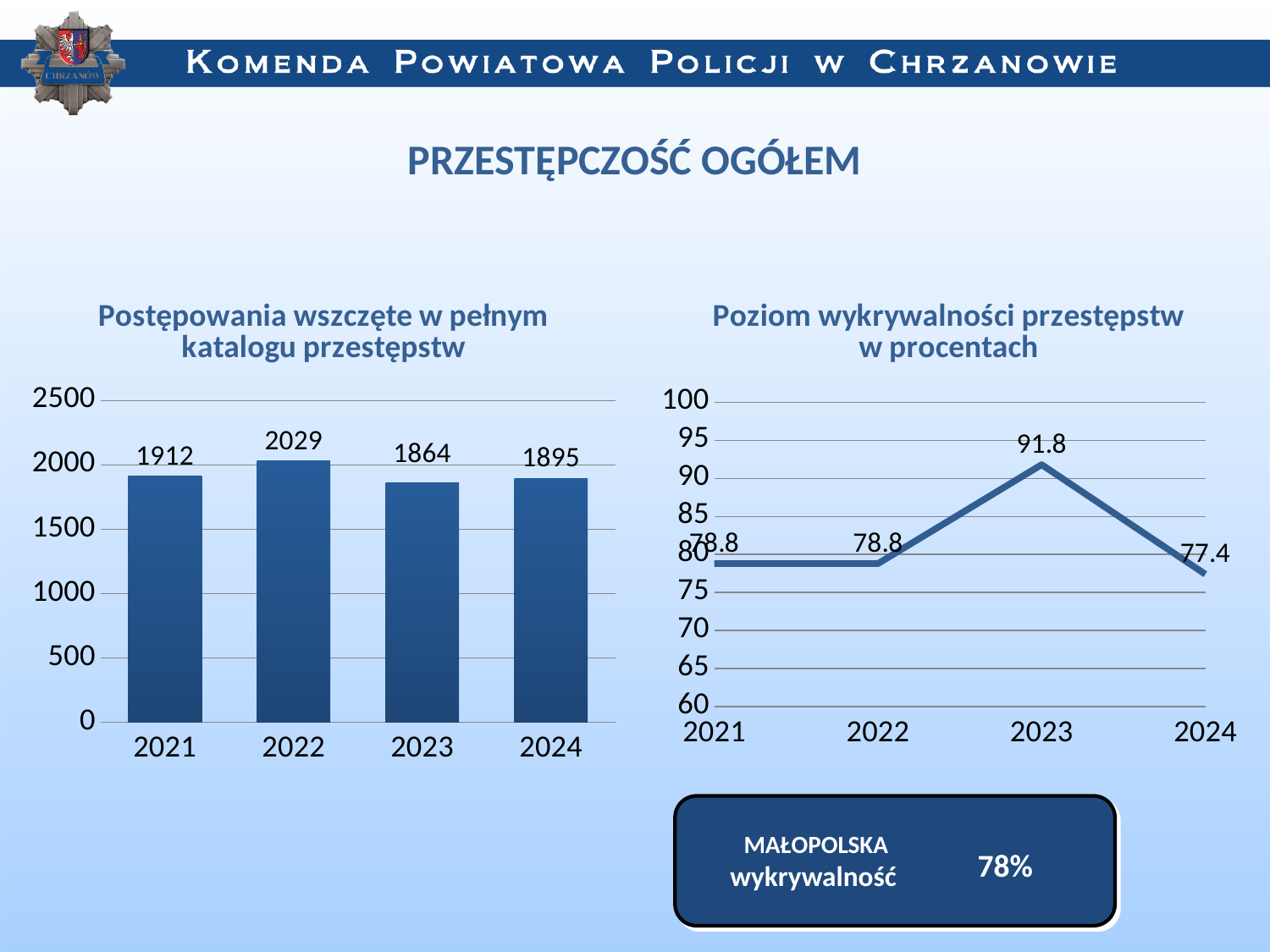
In the chart 'Postępowania wszczęte w pełnym katalogu przestępstw', which year has the highest value? 2022 In the chart 'Poziom wykrywalności przestępstw w procentach', what is the value for 2023? 91.8 In the chart 'Poziom wykrywalności przestępstw w procentach', is the value for 2024 greater or less than 80? less In the chart 'Postępowania wszczęte w pełnym katalogu przestępstw', what is the value for 2022? 2029 In the chart 'Poziom wykrywalności przestępstw w procentach', which year has the highest value? 2023 In the chart 'Poziom wykrywalności przestępstw w procentach', what is the value for 2024? 77.4 What kind of chart is 'Poziom wykrywalności przestępstw w procentach'? line chart In the chart 'Postępowania wszczęte w pełnym katalogu przestępstw', how many years are shown on the x axis? 4 In the chart 'Poziom wykrywalności przestępstw w procentach', what is the difference between the values for 2023 and 2024? 14.4 What kind of chart is 'Postępowania wszczęte w pełnym katalogu przestępstw'? bar chart In the chart 'Postępowania wszczęte w pełnym katalogu przestępstw', what is the difference between the values for 2022 and 2021? 117 In the chart 'Postępowania wszczęte w pełnym katalogu przestępstw', which year has the lowest value? 2023